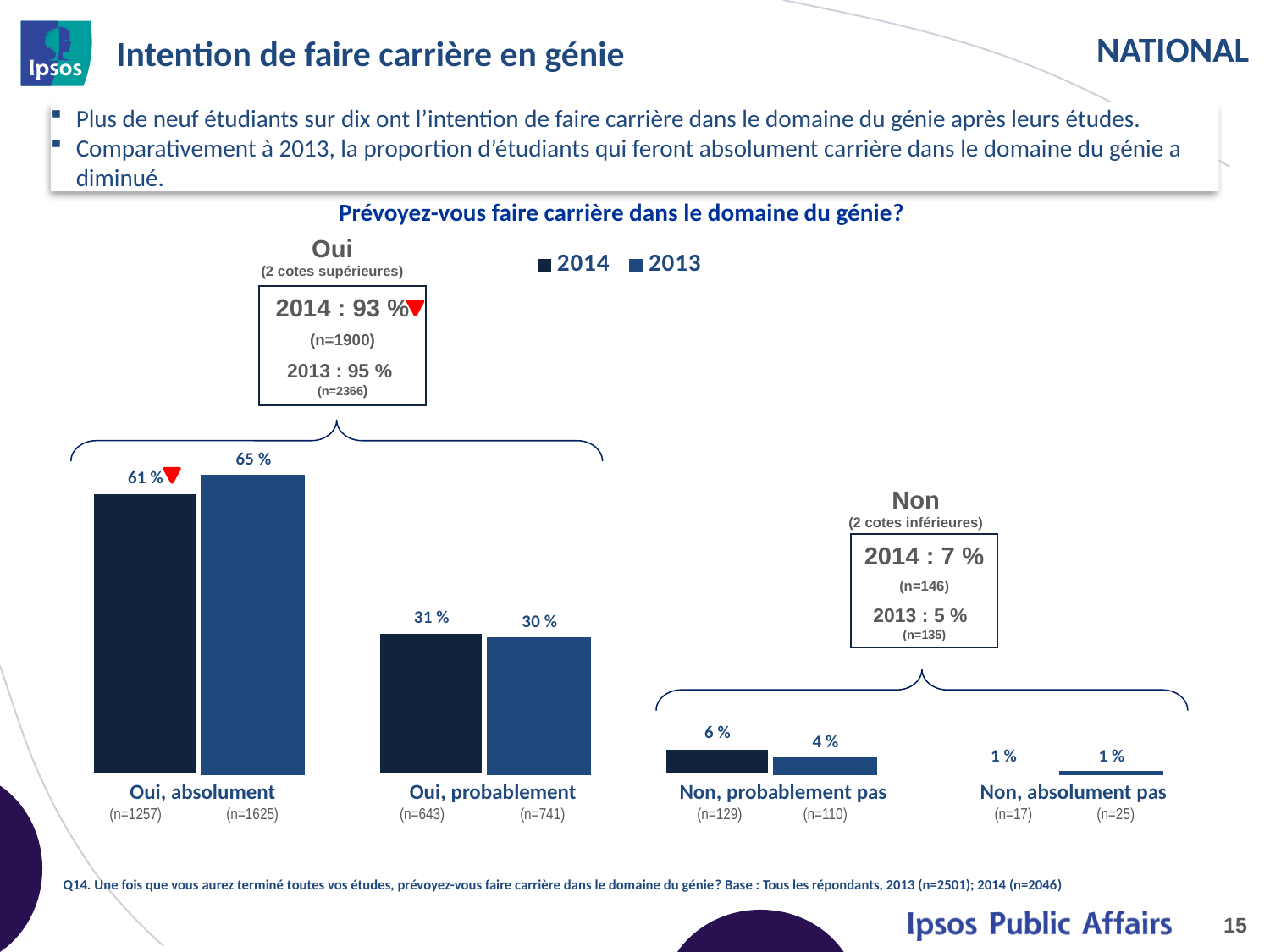
What kind of chart is shown on the slide? Bar chart How many categories are shown on the x axis of the chart? 4 For "Non, probablement pas", which is larger: the 2014 value or the 2013 value? 2014 Which category has the highest 2014 value? Oui, absolument What is the 2014 value for "Oui, absolument"? 61 % Which category has the lowest 2013 value? Non, absolument pas What is the 2013 value for "Non, probablement pas"? 4 % How many series does the legend list? 2 What is the 2014 value for "Oui, probablement"? 31 % What is the 2013 value for "Oui, absolument"? 65 % What is the title of the chart? Prévoyez-vous faire carrière dans le domaine du génie? What is the difference between the 2013 and 2014 values for "Oui, absolument"? 4 %